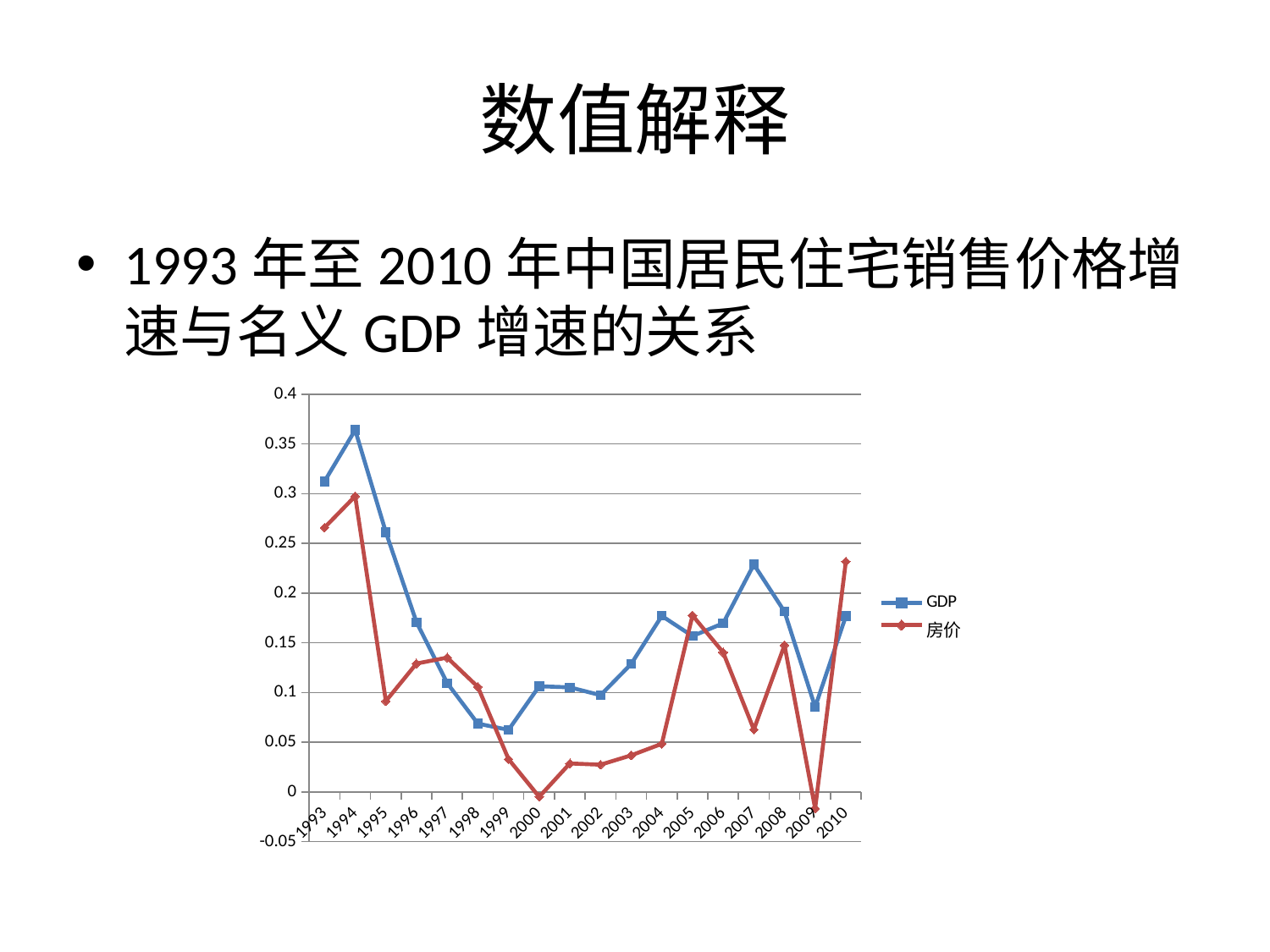
In which year does the 房价 series reach its lowest value? 2009 In which year does the GDP series reach its lowest value? 1999 How many series does the chart's legend list? 2 In which year does the GDP series reach its highest value? 1994 Does the GDP series rise or fall from 1994 to 1999? fall In 2007, which series has the larger value, GDP or 房价? GDP What kind of chart is shown on the slide? line chart What are the two series named in the legend? GDP and 房价 How many years are plotted along the x axis? 18 Is the value for GDP in 2007 greater or less than 0.2? greater Is the value for 房价 in 2002 greater or less than 0.05? less Is the value for 房价 in 2000 greater or less than 0.05? less